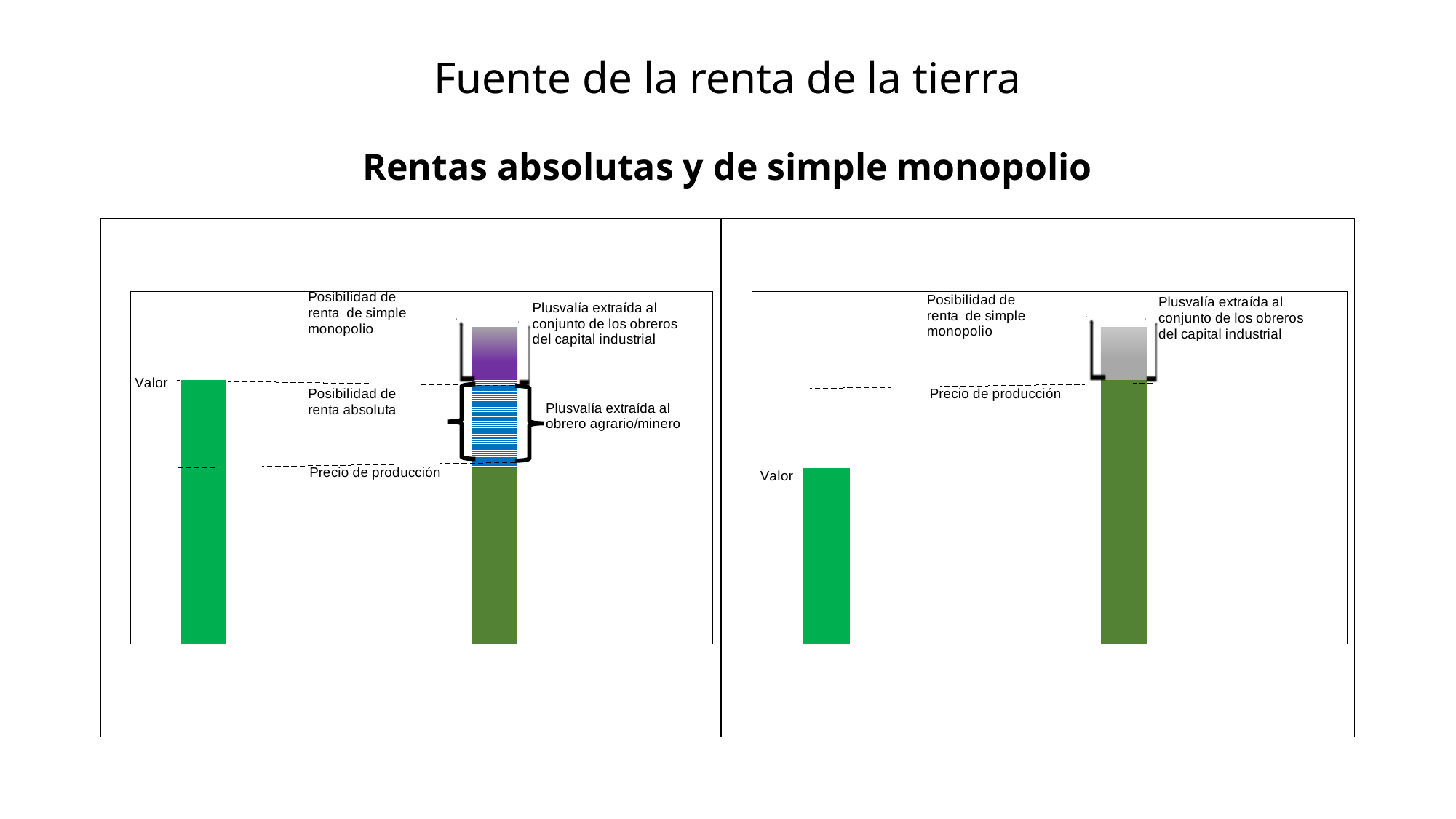
In the right chart, which bar is taller: the 'Valor' bar on the left or the dark green bar on the right? the dark green bar on the right In the left chart, which is higher: the level labelled 'Valor' or the level labelled 'Precio de producción'? Valor In the right chart, how many bars are plotted? 2 In the left chart, which bar is taller: the 'Valor' bar on the left or the dark green bar on the right? the dark green bar on the right In the left chart, what label is given to the blue striped section of the right-hand bar? Posibilidad de renta absoluta What is the bold subtitle above the two charts on the slide? Rentas absolutas y de simple monopolio What kind of chart is shown in the right panel of the slide? bar chart In the left chart, how many bars are plotted? 2 What kind of chart is shown in the left panel of the slide? bar chart